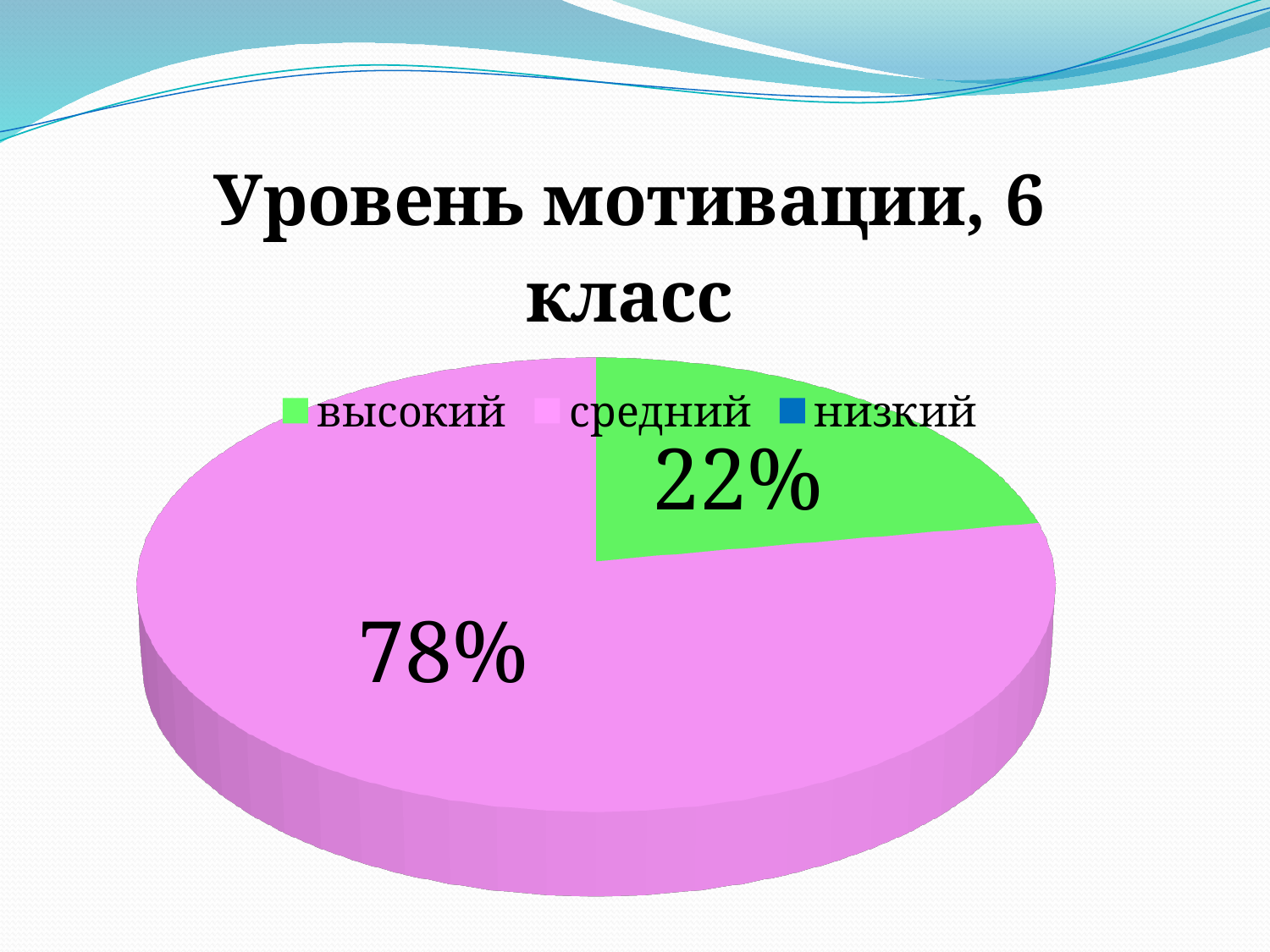
How many categories does the legend list? 3 Is the share for "высокий" greater or less than 50%? less Which legend entry is shown in green? высокий What share of the pie does the "высокий" slice take? 22% What is the title of the chart? Уровень мотивации, 6 класс Is the share for "средний" greater or less than 50%? greater Which category has the largest slice of the pie? средний What is the difference in percentage points between the "средний" and "высокий" slices? 56 What kind of chart is shown on the slide? pie chart Which of the two visible slices is larger, "высокий" or "средний"? средний What share of the pie does the "средний" slice take? 78% How many slices with data labels are visible in the pie? 2